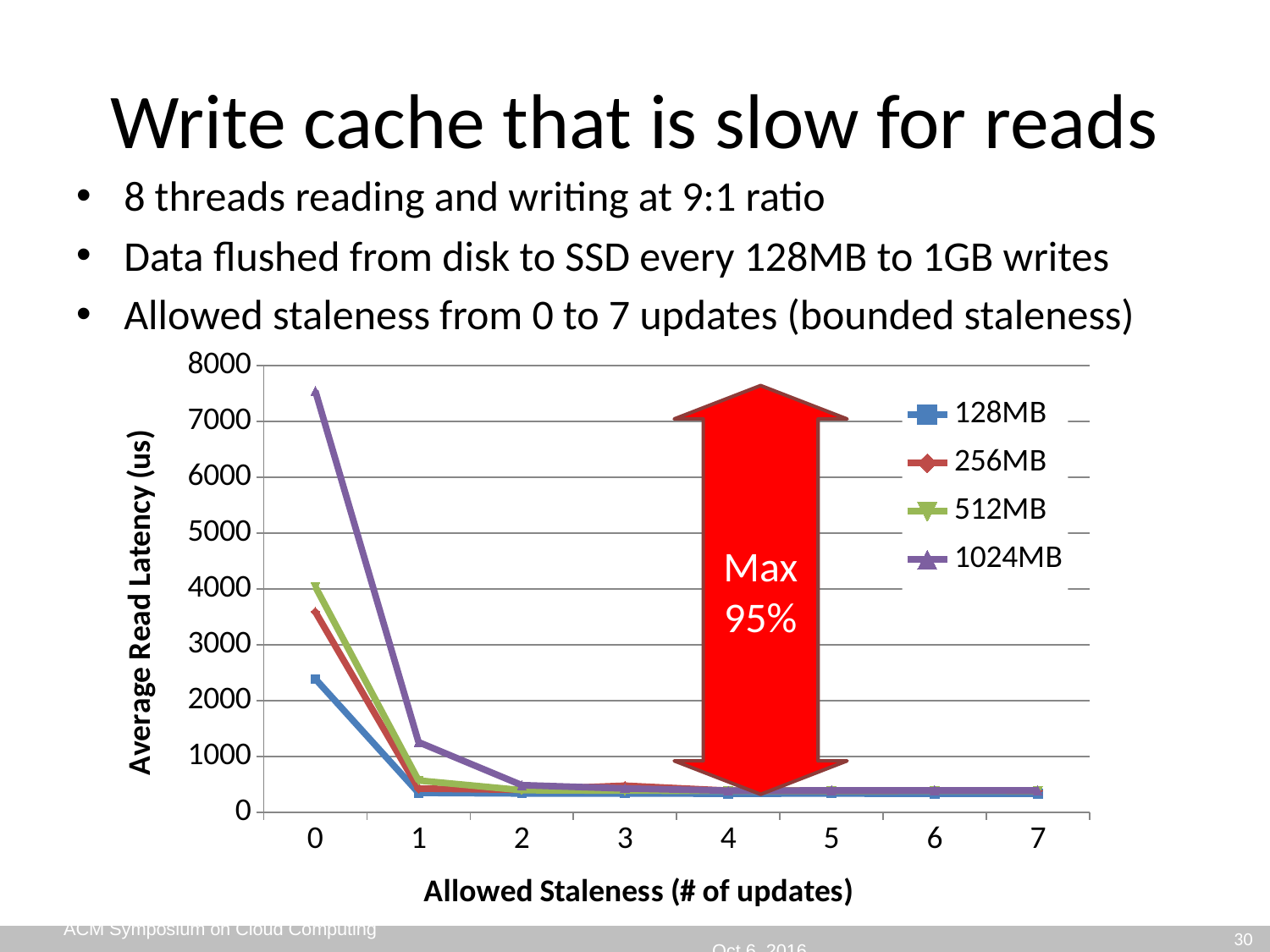
Is the average read latency for 1024MB at an allowed staleness of 1 greater or less than 1000? greater How many allowed staleness values are plotted along the x axis? 8 Does the average read latency rise or fall as allowed staleness increases from 0 to 7? fall What is the label of the y axis of the chart? Average Read Latency (us) Is the average read latency for 1024MB at an allowed staleness of 0 greater or less than 7000? greater Is the average read latency for 512MB at an allowed staleness of 7 greater or less than 1000? less Which series has the lowest average read latency at an allowed staleness of 0? 128MB How many series does the chart legend list? 4 Which series has the highest average read latency at an allowed staleness of 0? 1024MB What kind of chart is shown on the slide? line chart